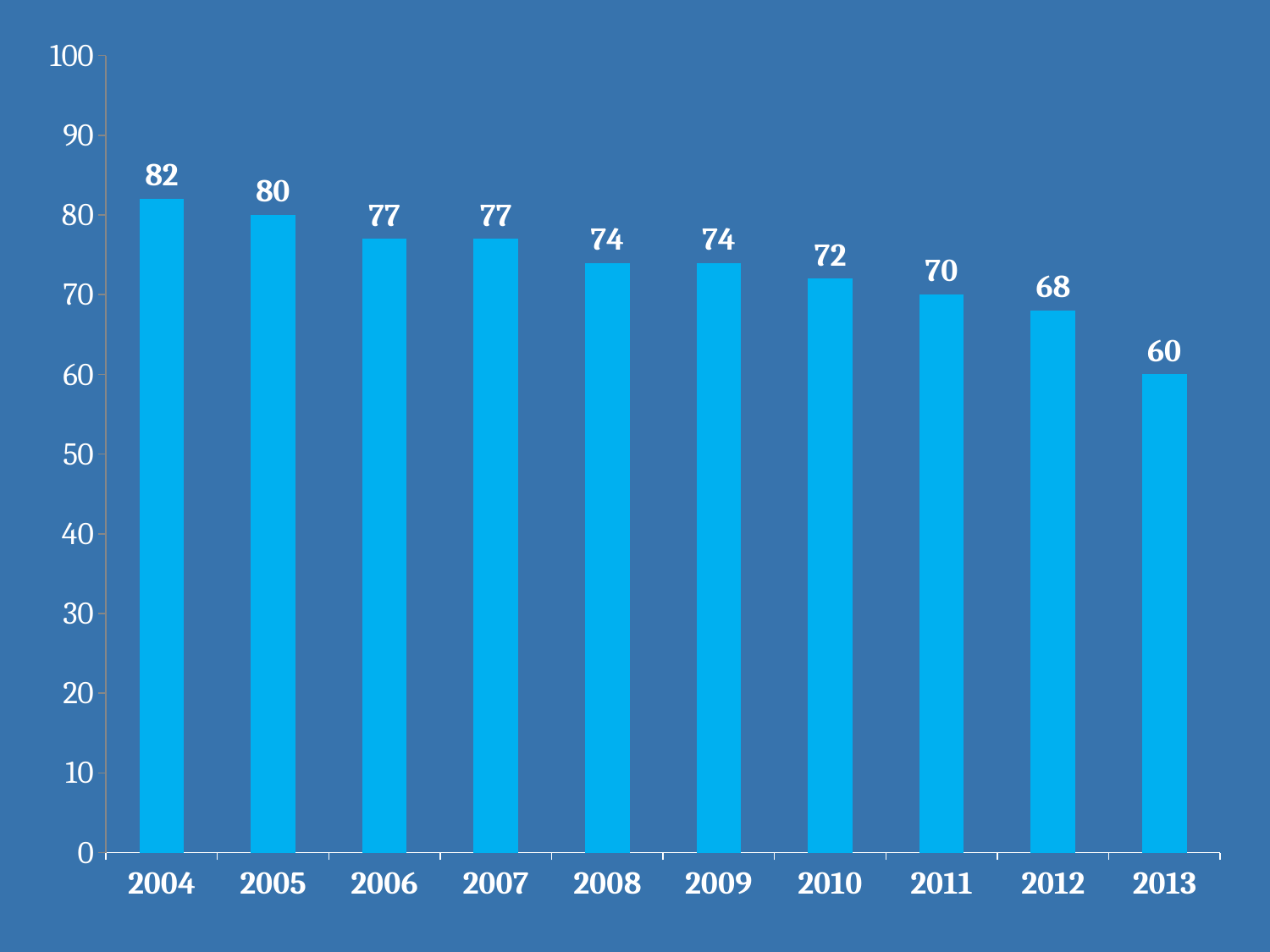
What is the value for 2013? 60 Which is larger, the value for 2005 or the value for 2009? 2005 What is the value for 2004? 82 What is the difference between the values for 2004 and 2013? 22 What is the difference between the values for 2011 and 2012? 2 Which year has the highest value? 2004 Is the value for 2008 greater or less than 70? greater What kind of chart is shown on the slide? bar chart What is the value for 2010? 72 Do the values generally rise or fall from 2004 to 2013? fall Which year has the lowest value? 2013 How many years are shown on the x axis? 10